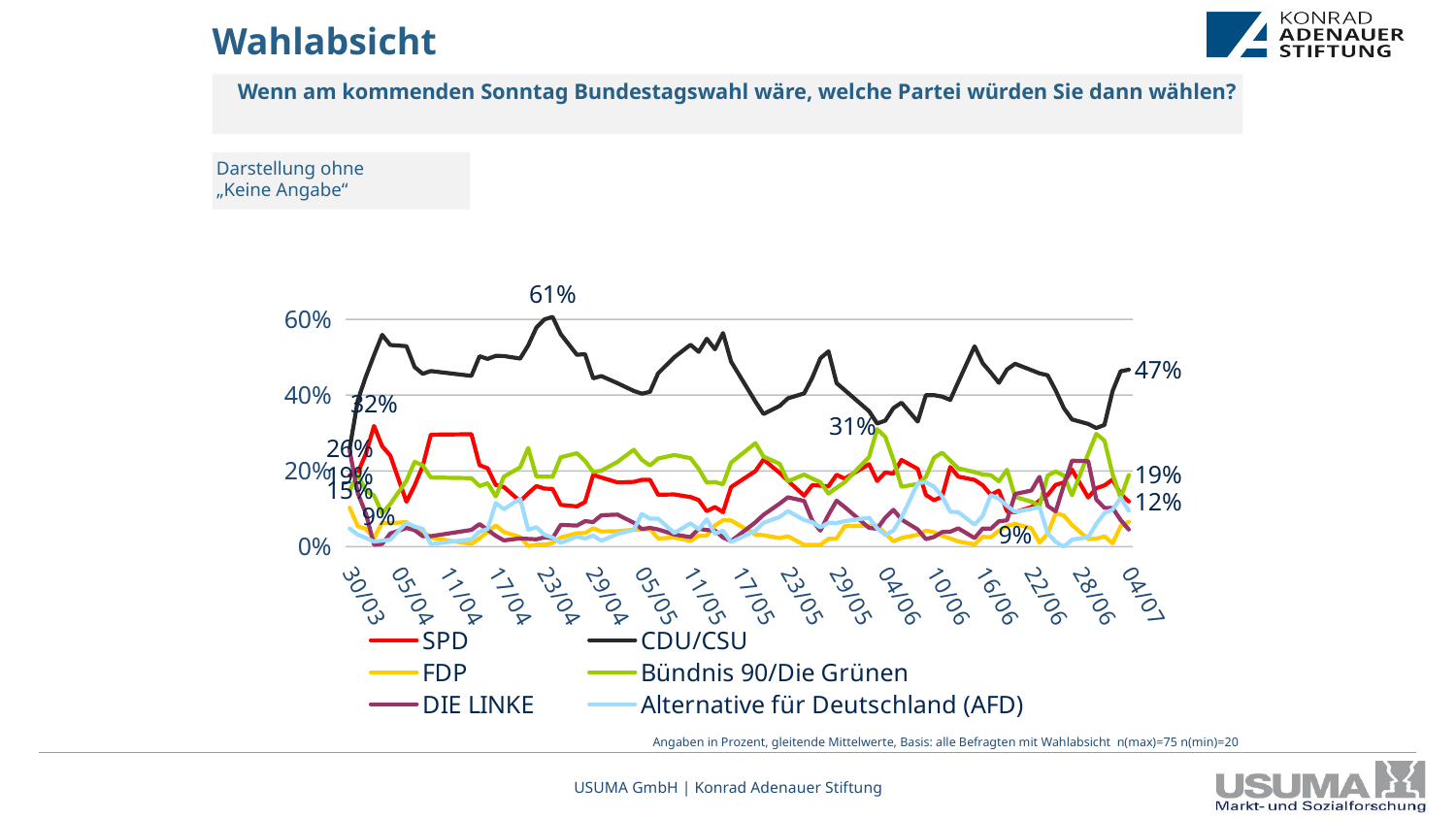
Does the CDU/CSU line rise or fall between 30/03 and 23/04? rise At 04/07, which is larger: the value for CDU/CSU or the value for SPD? CDU/CSU How many date labels are shown on the x axis? 17 What is the title of the slide containing the chart? Wahlabsicht What is the highest value labelled on the chart? 61% Which party's line is the highest across the whole period? CDU/CSU Is the value for SPD at 30/03 greater or less than 40%? less How many series does the legend list? 6 What value is labelled at the end of the CDU/CSU line at 04/07? 47% Is the value for CDU/CSU at 23/04 greater or less than 40%? greater Which colour is used for the CDU/CSU line? black What kind of chart is shown on the slide? line chart